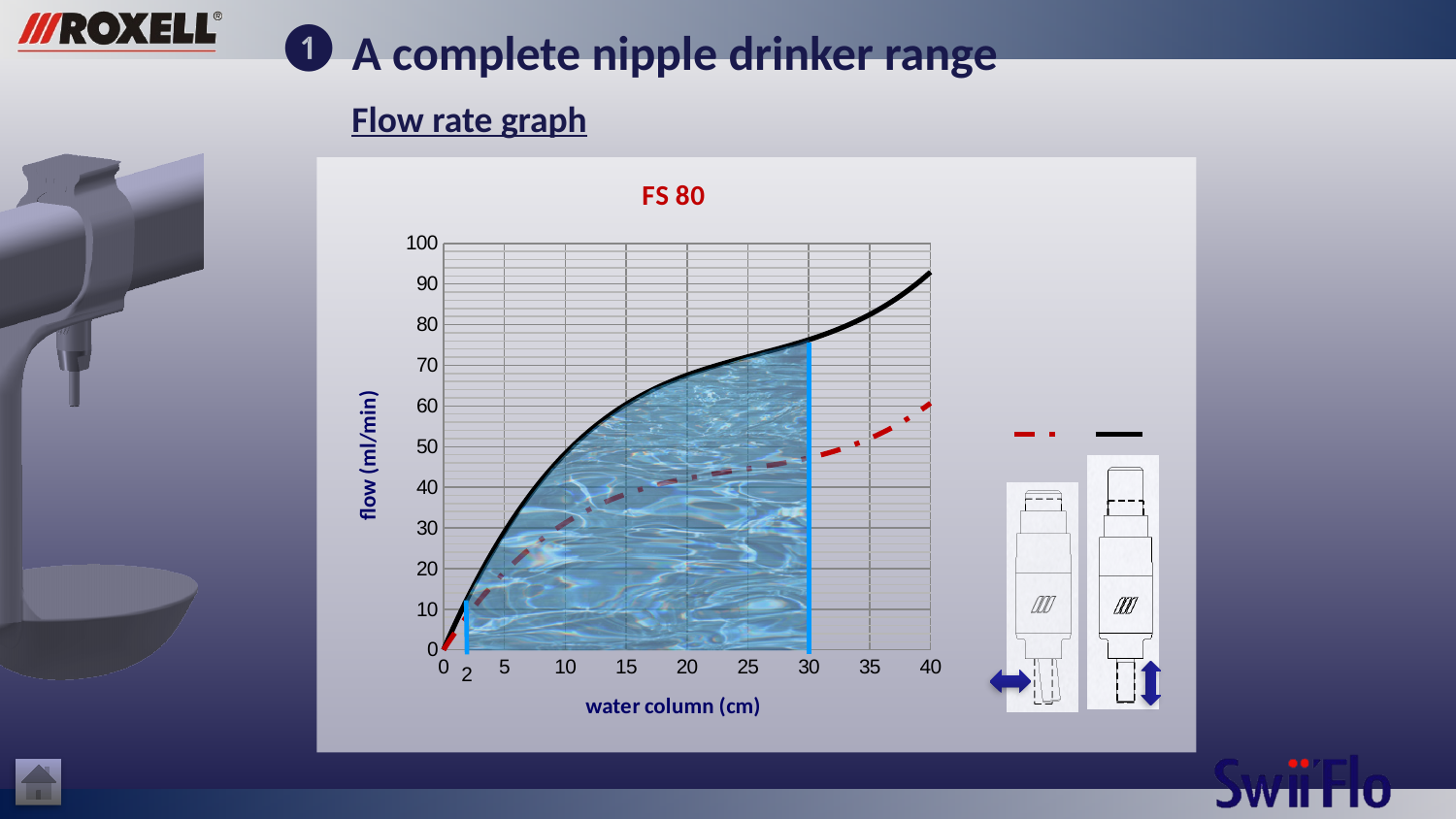
How many lines (series) are plotted on the chart? 2 What is the title of the chart? FS 80 Which line reaches the highest flow value on the chart? solid black line What kind of chart is shown on the slide? line chart At a water column of 20 cm, which line shows the higher flow, the solid black line or the dashed red line? solid black line Is the flow of the solid black line at a water column of 30 cm greater or less than 70 ml/min? greater Does the flow of the dashed red line rise or fall as the water column increases? rise Is the flow of the solid black line at a water column of 40 cm greater or less than 80 ml/min? greater Is the flow of the dashed red line at a water column of 40 cm greater or less than 50 ml/min? greater Does the flow of the solid black line rise or fall as the water column increases? rise What is the label of the x axis of the chart? water column (cm)